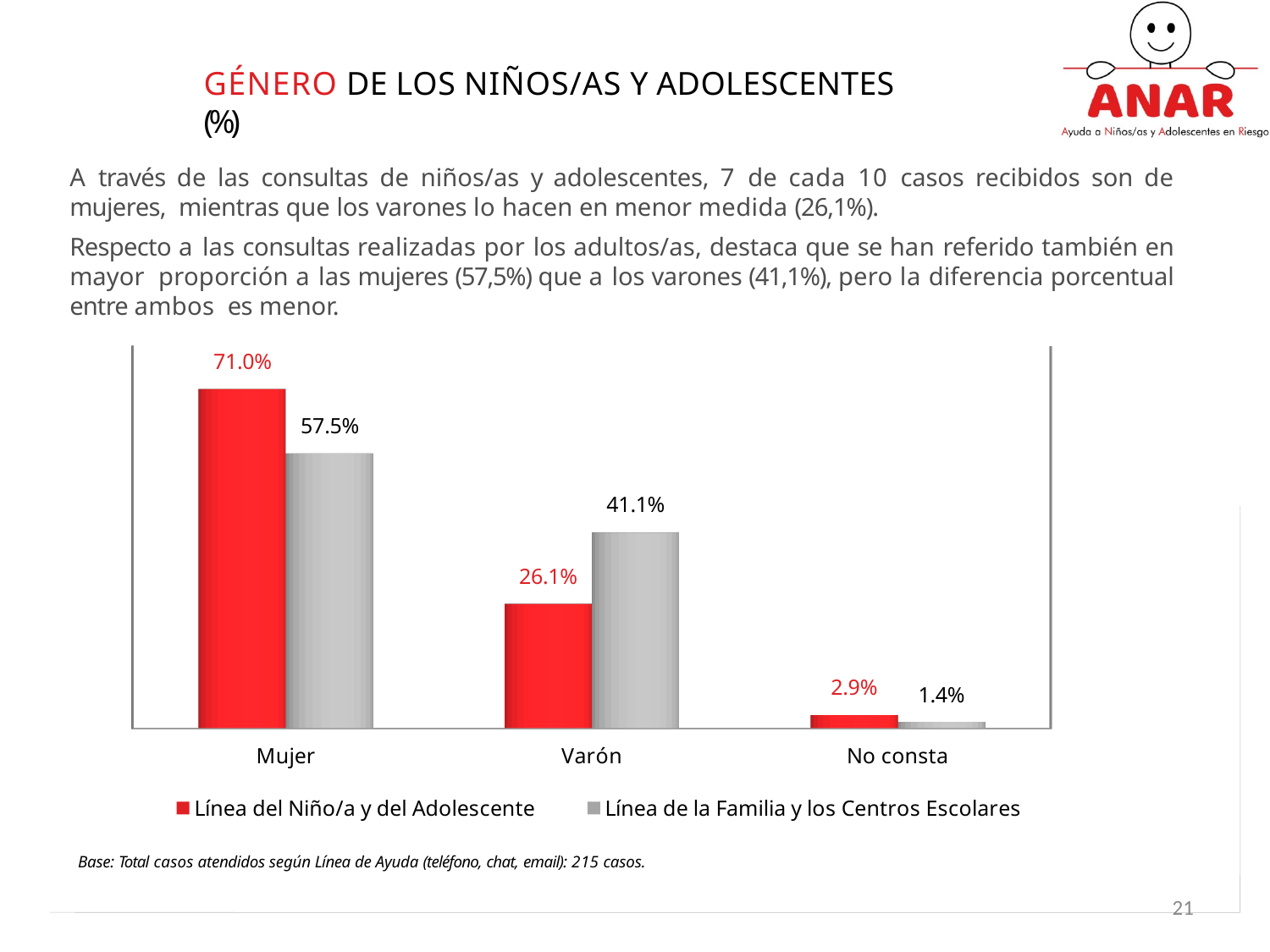
Which colour represents the Línea del Niño/a y del Adolescente series? Red For Varón, which series has the larger value? Línea de la Familia y los Centros Escolares What is the value for Mujer in the Línea del Niño/a y del Adolescente series? 71.0% How many categories are shown on the x axis? 3 What is the difference between the Línea del Niño/a y del Adolescente and Línea de la Familia y los Centros Escolares values for Mujer? 13.5% What is the difference between the two series' values for Varón? 15.0% What is the value for No consta in the Línea del Niño/a y del Adolescente series? 2.9% Which category has the highest value in the Línea de la Familia y los Centros Escolares series? Mujer What kind of chart is shown on the slide? Bar chart What is the value for Varón in the Línea de la Familia y los Centros Escolares series? 41.1% Which category has the lowest value in the Línea del Niño/a y del Adolescente series? No consta How many series does the legend list? 2